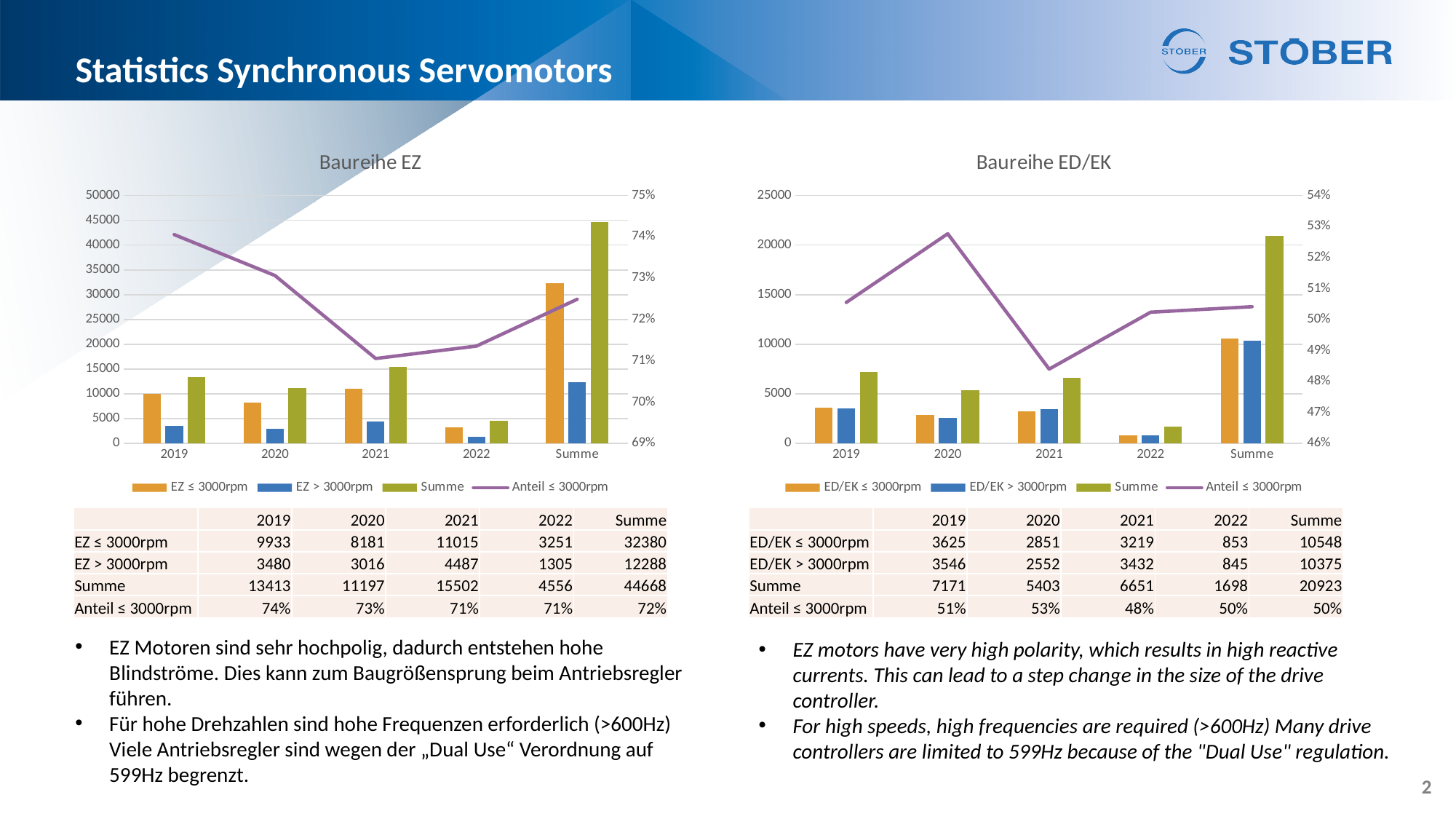
How many categories are shown on the x axis of the Baureihe ED/EK chart? 5 In the Baureihe EZ chart, what is the Anteil ≤ 3000rpm for 2019? 74% In the Baureihe EZ chart, does the Anteil ≤ 3000rpm line rise or fall from 2019 to 2021? fall In the Baureihe ED/EK chart, what is the Anteil ≤ 3000rpm for 2020? 53% In the Baureihe EZ chart, which year has the lowest Summe value? 2022 How many series does the legend of the Baureihe EZ chart list? 4 In the Baureihe EZ chart, what is the difference between EZ ≤ 3000rpm and EZ > 3000rpm in 2020? 5165 In the Baureihe EZ chart, what is the value for EZ ≤ 3000rpm in 2021? 11015 In the Baureihe ED/EK chart, what is the value for ED/EK > 3000rpm in 2022? 845 In the Baureihe ED/EK chart, which is larger: the Summe value for 2020 or for 2021? 2021 In the Baureihe ED/EK chart, which of the years 2019 to 2022 has the highest Summe value? 2019 In the Baureihe ED/EK chart, is the Summe value for 2021 greater or less than 5000? greater